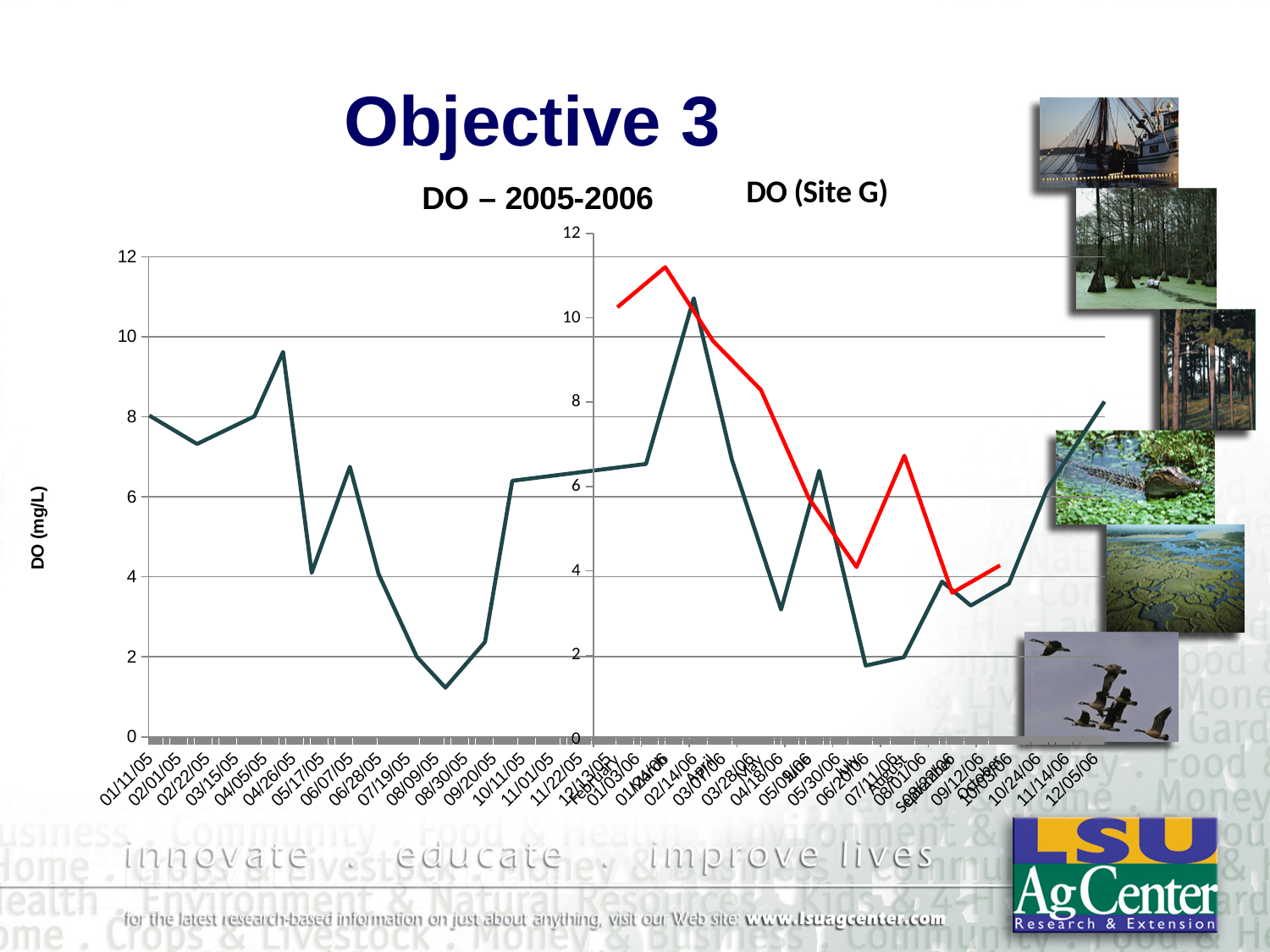
In the 'DO – 2005-2006' chart, do the values rise or fall between 06/07/05 and 08/30/05? fall In the 'DO (Site G)' chart, is the dark line's value for 02/14/06 greater or less than 10? greater What type of chart is the 'DO – 2005-2006' chart on the left? line chart In the 'DO (Site G)' chart, is the dark line's value for 06/20/06 greater or less than 2? less In the 'DO – 2005-2006' chart, is the value for 08/30/05 greater or less than 2? less In the 'DO – 2005-2006' chart, which is larger, the value for 04/26/05 or the value for 06/07/05? 04/26/05 What is the y-axis label of the 'DO – 2005-2006' chart? DO (mg/L) In the 'DO (Site G)' chart, how many lines are plotted? 1 In the 'DO (Site G)' chart, which is larger for the dark line, the value for 02/14/06 or the value for 05/30/06? 02/14/06